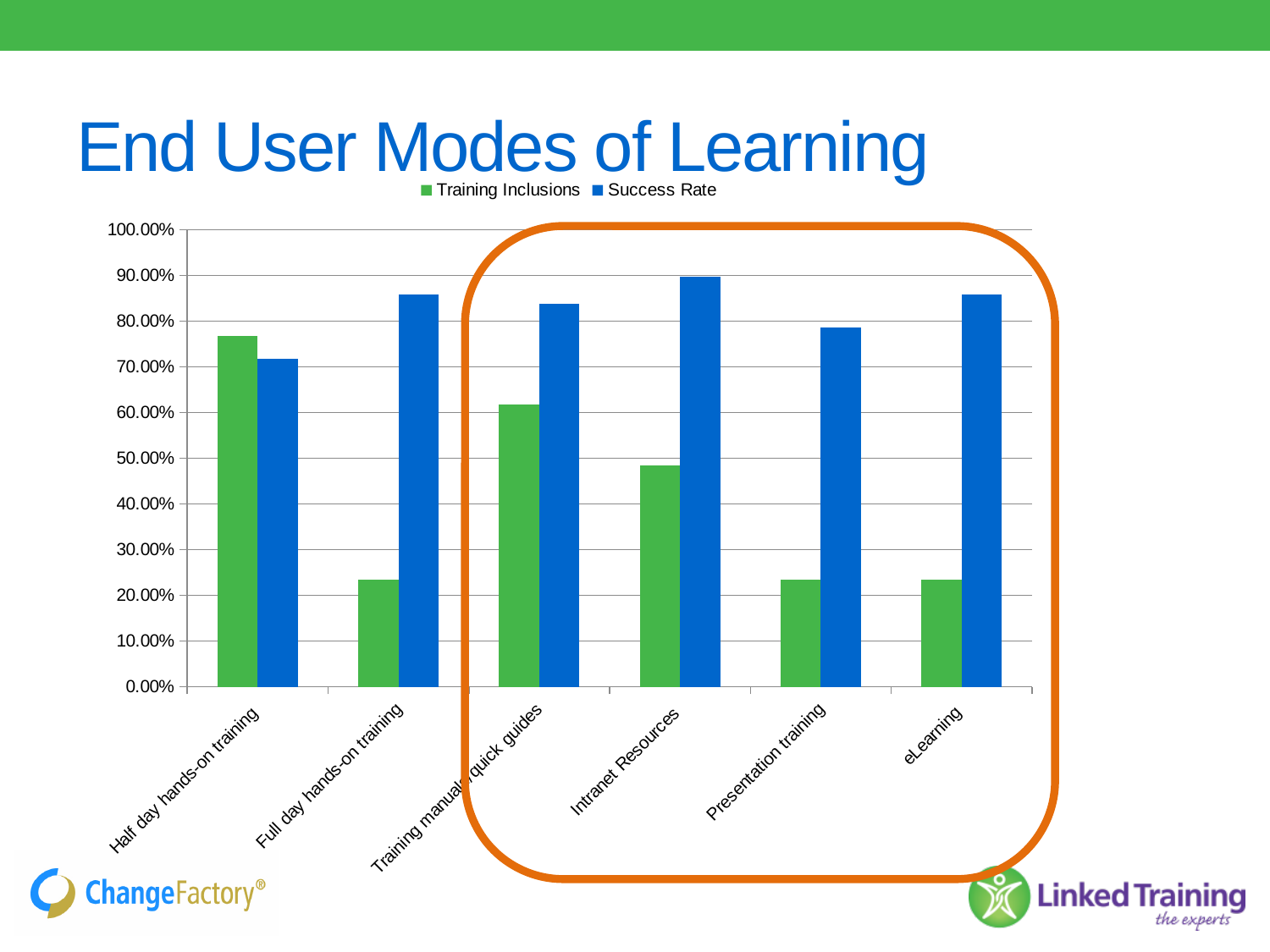
What kind of chart is shown on the slide? bar chart Which category has the highest Training Inclusions value? Half day hands-on training Is the Training Inclusions value for Half day hands-on training greater or less than 70.00%? greater Which category has the highest Success Rate? Intranet Resources How many series does the legend list? 2 Is the Success Rate for Full day hands-on training greater or less than 80.00%? greater Which colour represents the Success Rate series? blue Which category has the lowest Success Rate? Half day hands-on training Is the Training Inclusions value for eLearning greater or less than 30.00%? less For Half day hands-on training, which is larger: Training Inclusions or Success Rate? Training Inclusions How many categories (modes of learning) are shown on the x axis? 6